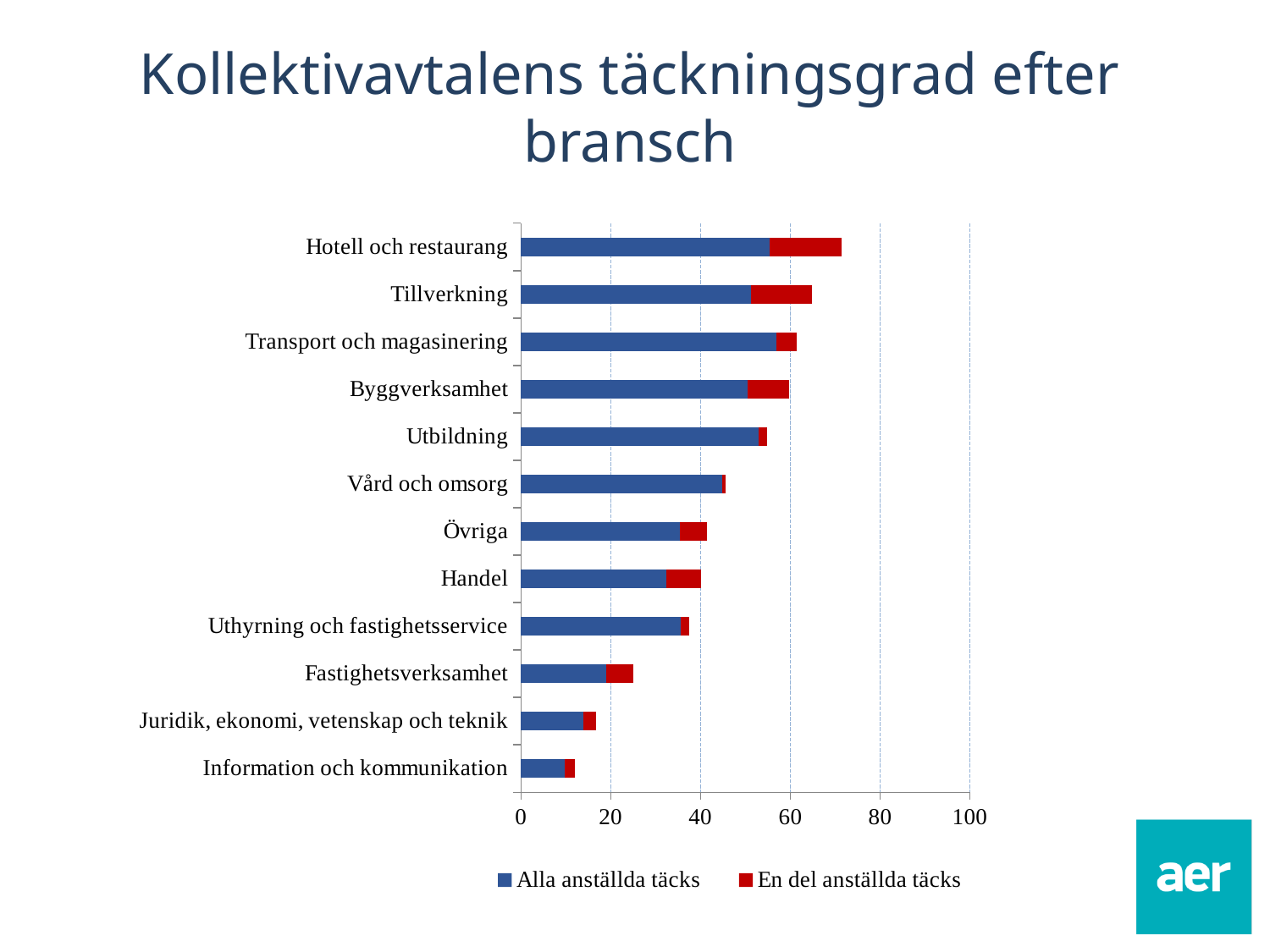
Which has the longer total bar, Fastighetsverksamhet or Juridik, ekonomi, vetenskap och teknik? Fastighetsverksamhet Is the total bar for Fastighetsverksamhet greater or less than 20? greater Which industry has the longest total bar? Hotell och restaurang Is the total bar for Hotell och restaurang greater or less than 60? greater How many series does the legend list? 2 How many industries (categories) are shown in the chart? 12 Is the 'Alla anställda täcks' value for Vård och omsorg greater or less than 40? greater What kind of chart is shown on the slide? Bar chart Which has the longer total bar, Hotell och restaurang or Tillverkning? Hotell och restaurang Which industry has the shortest total bar? Information och kommunikation What is the title of the chart on the slide? Kollektivavtalens täckningsgrad efter bransch